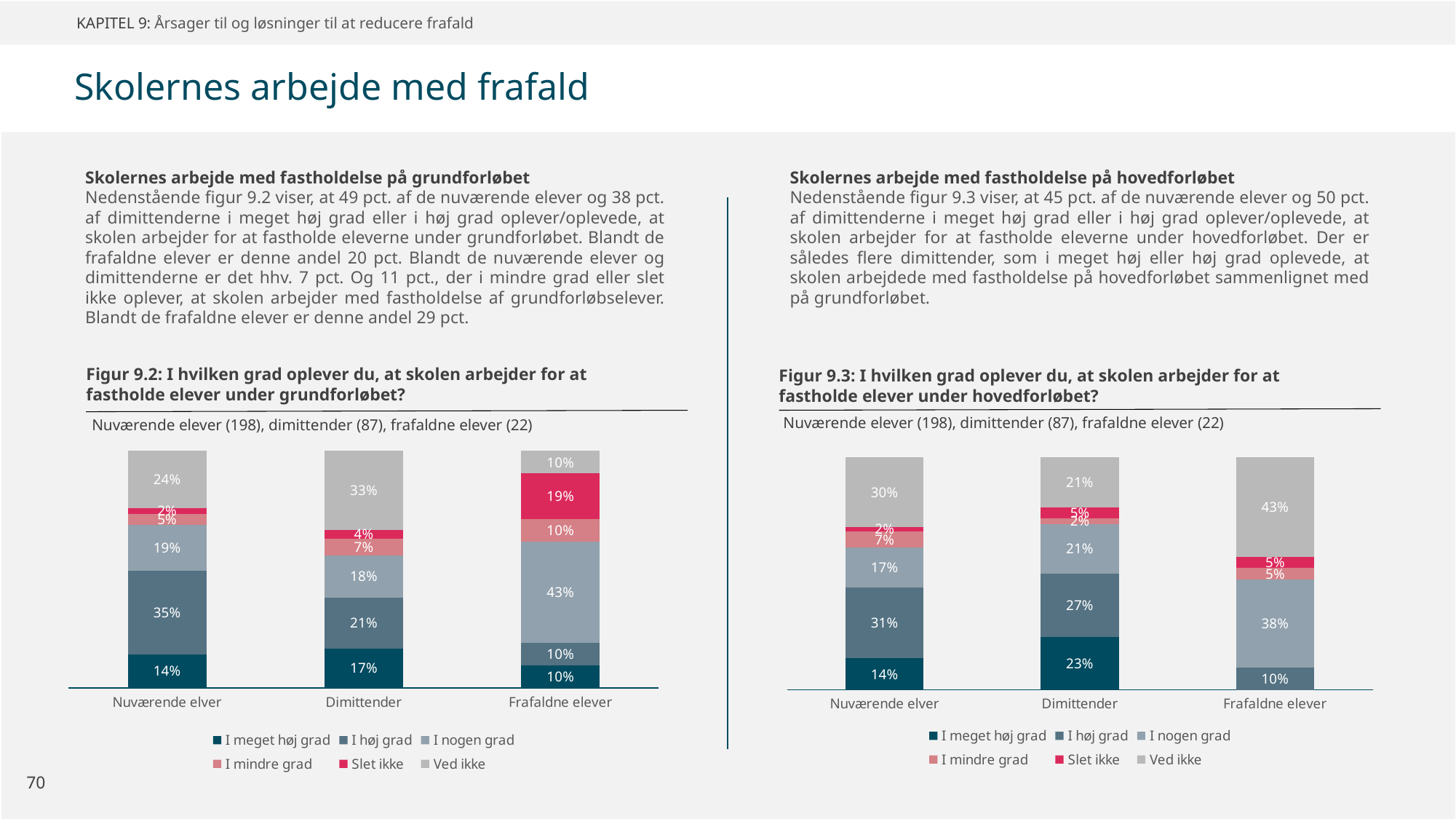
In Figur 9.3, which is larger: the 'I nogen grad' share for Dimittender or for Nuværende elver? Dimittender How many groups are shown on the x axis of Figur 9.3? 3 In Figur 9.3, what percentage of Frafaldne elever answered 'Ved ikke'? 43% In Figur 9.2, what percentage of Nuværende elver answered 'I høj grad'? 35% In Figur 9.2, what percentage of Frafaldne elever answered 'I nogen grad'? 43% In Figur 9.3, which group has the highest share answering 'I høj grad'? Nuværende elver How many series does the legend of Figur 9.2 list? 6 What type of chart is Figur 9.2? Stacked bar chart In Figur 9.2, which group has the lowest share answering 'I meget høj grad'? Frafaldne elever In Figur 9.2, what percentage of Dimittender answered 'Ved ikke'? 33% In Figur 9.2, what is the difference between the 'Slet ikke' share for Frafaldne elever and for Dimittender? 15 percentage points In Figur 9.3, what percentage of Dimittender answered 'I meget høj grad'? 23%